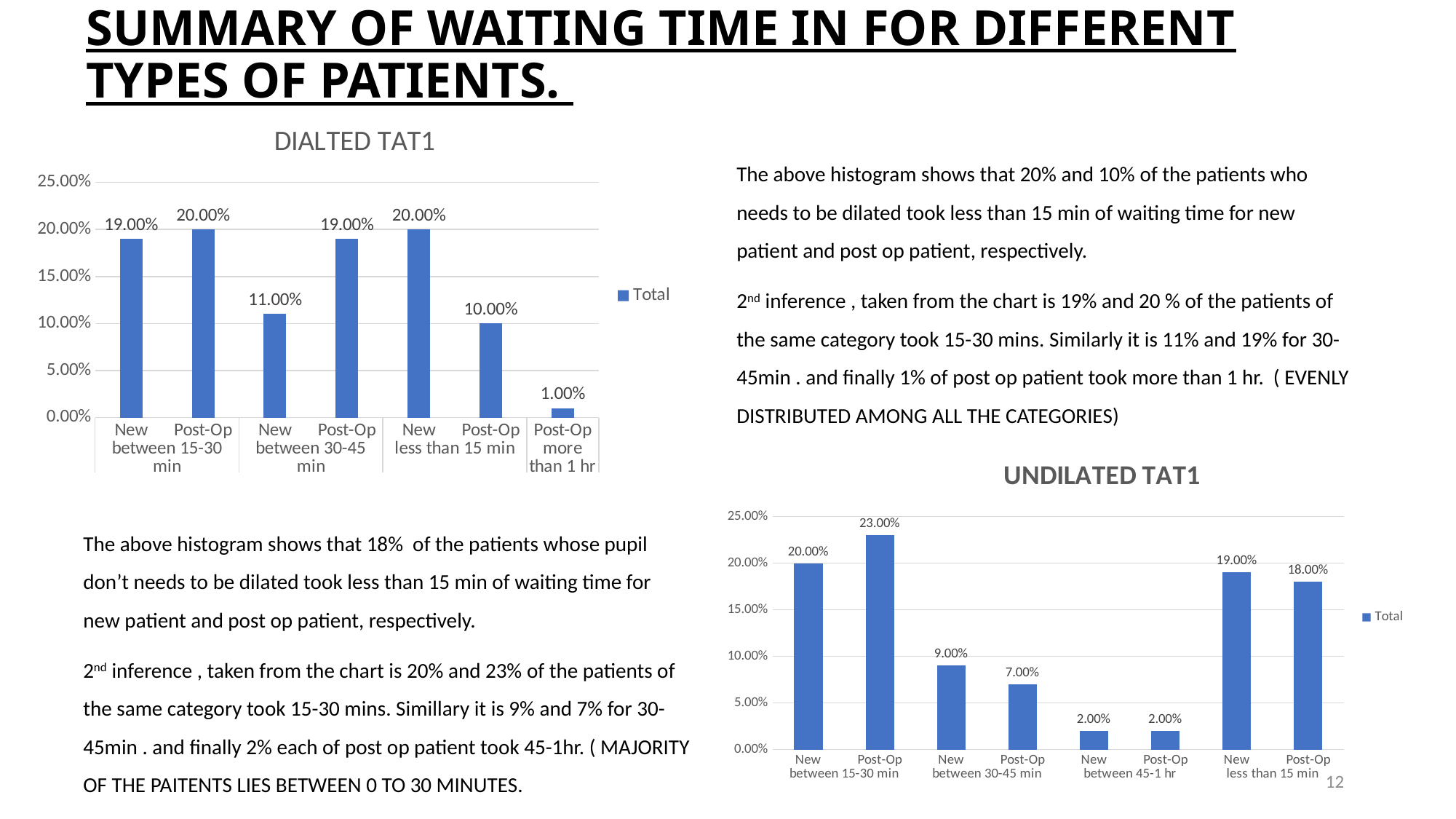
In the UNDILATED TAT1 chart, what is the value for Post-Op patients between 15-30 min? 23.00% In the UNDILATED TAT1 chart, what is the difference between New less than 15 min and Post-Op less than 15 min? 1.00% In the UNDILATED TAT1 chart, which is larger: New between 30-45 min or Post-Op between 30-45 min? New between 30-45 min In the DIALTED TAT1 chart, what is the difference between Post-Op between 15-30 min and New between 30-45 min? 9.00% In the DIALTED TAT1 chart, what is the value for New patients between 30-45 min? 11.00% In the DIALTED TAT1 chart, which category has the lowest value? Post-Op more than 1 hr In the DIALTED TAT1 chart, how many series does the legend list? 1 In the UNDILATED TAT1 chart, which category has the highest value? Post-Op between 15-30 min In the DIALTED TAT1 chart, what is the value for Post-Op patients less than 15 min? 10.00% What type of chart is the UNDILATED TAT1 chart? Bar chart In the DIALTED TAT1 chart, how many bars are plotted? 7 In the UNDILATED TAT1 chart, how many categories are plotted? 8